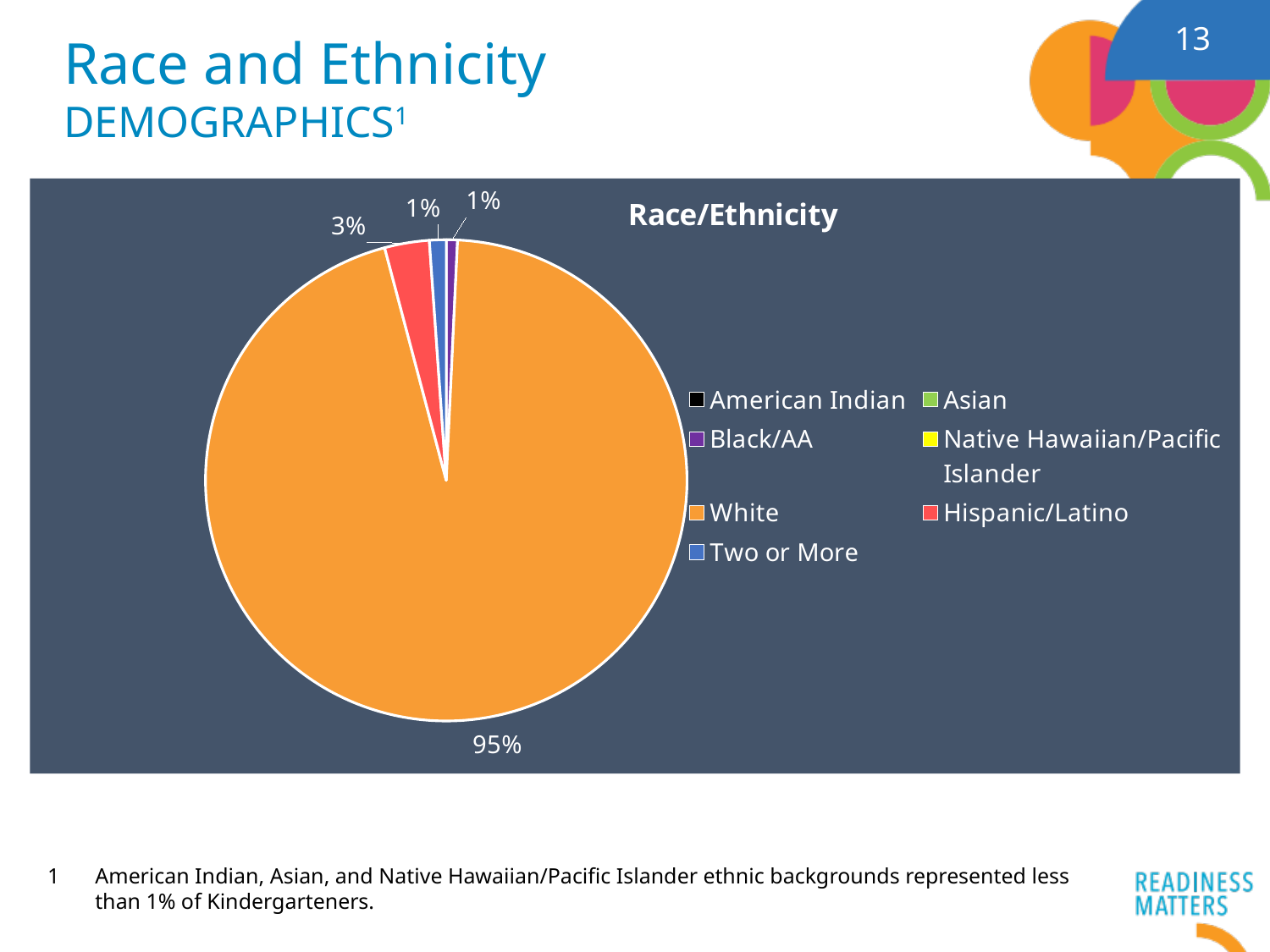
What is the difference in percentage points between the White share and the Hispanic/Latino share? 92 percentage points Which category has the largest share of the pie? White What kind of chart is shown on the slide? Pie chart What percentage of the pie is labelled for Two or More? 1% What colour is the White slice of the pie? Orange Which is larger, the share for Hispanic/Latino or the share for Two or More? Hispanic/Latino What percentage of the pie is labelled for Black/AA? 1% Which is larger, the share for White or the share for Hispanic/Latino? White What is the title of the chart? Race/Ethnicity What percentage of the pie is labelled for White? 95% What percentage of the pie is labelled for Hispanic/Latino? 3% How many categories does the legend list? 7